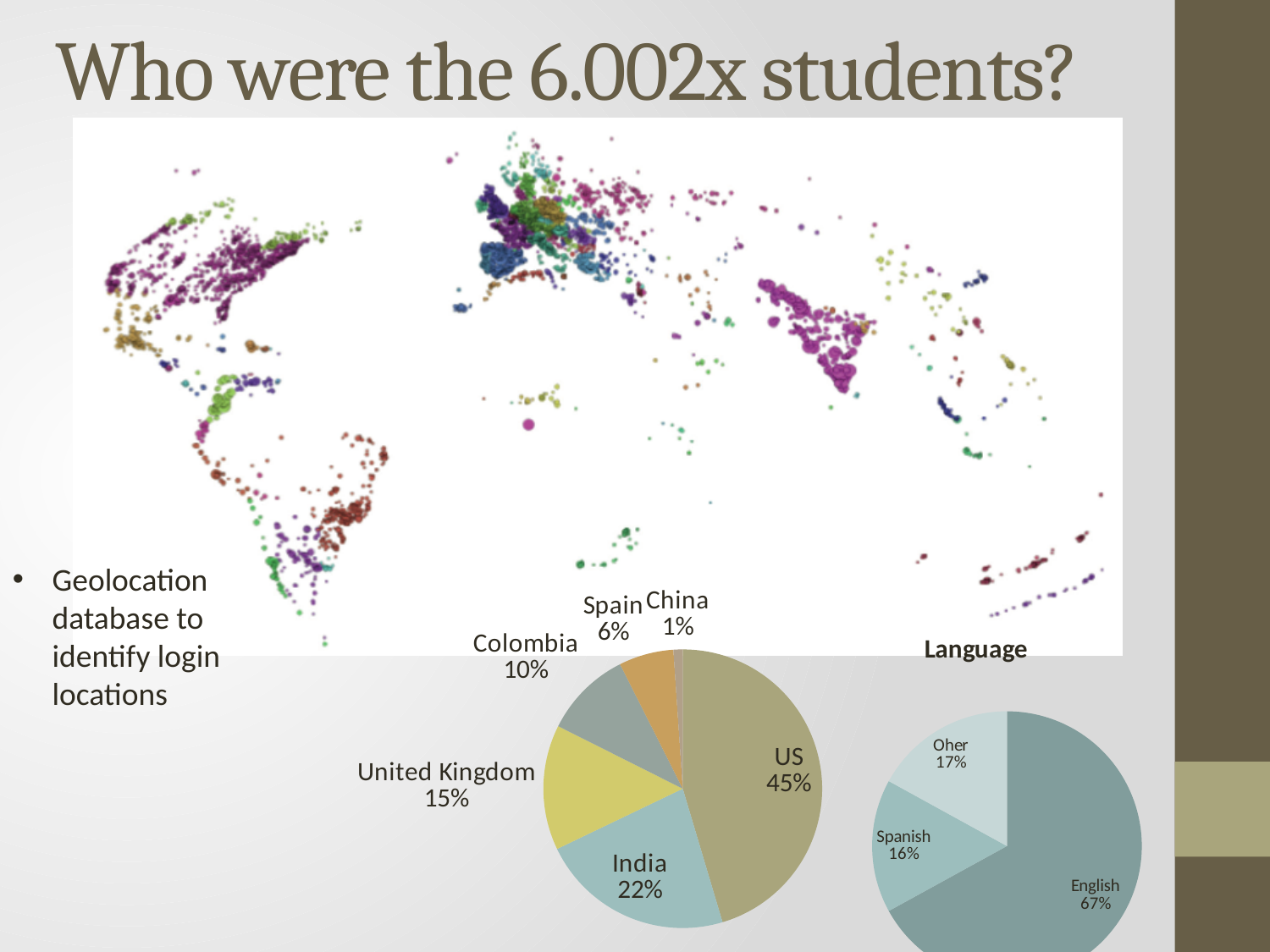
In the larger pie chart in the centre of the slide, which is larger, the share for Spain or the share for Colombia? Colombia In the larger pie chart in the centre of the slide, how many slices are there? 6 What type of chart is the 'Language' chart? Pie chart In the larger pie chart in the centre of the slide, what is the difference between the United Kingdom's share and Colombia's share? 5% In the larger pie chart in the centre of the slide, which country has the largest slice? US In the 'Language' pie chart, what share is English? 67% In the 'Language' pie chart, what is the difference between the English share and the Spanish share? 51% In the 'Language' pie chart, how many slices are there? 3 In the larger pie chart in the centre of the slide, what share of students is from the US? 45% In the 'Language' pie chart, what share is Spanish? 16% In the larger pie chart in the centre of the slide, what share of students is from India? 22% In the larger pie chart in the centre of the slide, which country has the smallest slice? China